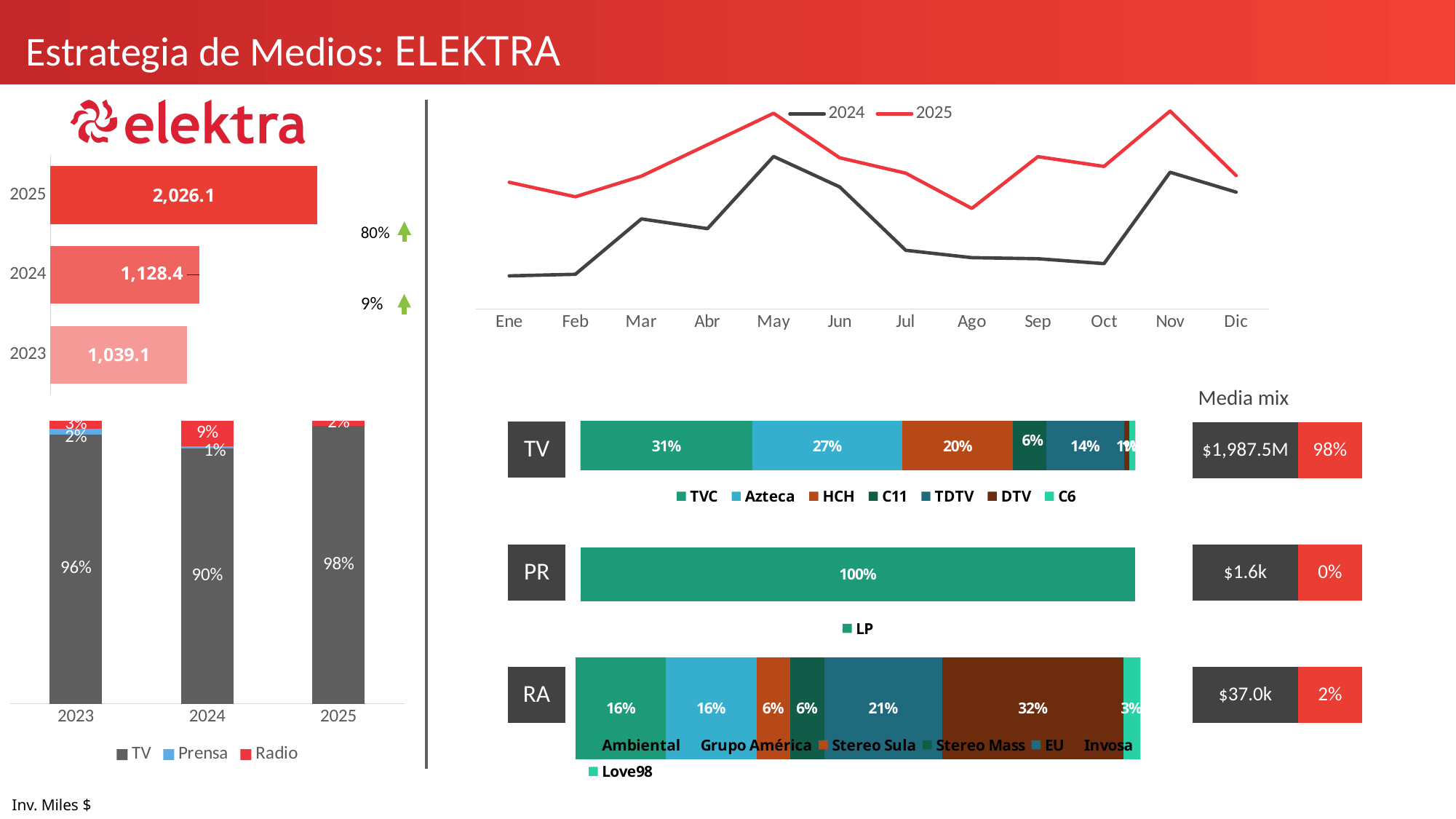
In the yearly investment bar chart on the left, what is the value for 2023? 1,039.1 In the stacked bar chart at the bottom left, what share does TV have in 2024? 90% In the yearly investment bar chart on the left, what is the difference between the 2025 and 2024 values? 897.7 In the TV channel mix bar, what share does Azteca have? 27% In the monthly line chart at the top right, how many months are shown on the x axis? 12 In the stacked bar chart at the bottom left, what share does Radio have in 2024? 9% In the yearly investment bar chart on the left, which year has the lowest value? 2023 How many series does the legend of the stacked bar chart at the bottom left list? 3 In the Media mix table, what is the investment amount shown for RA? $37.0k In the RA (radio) station mix bar, which station has the largest share? Invosa In the monthly line chart at the top right, which month has the highest value for the 2024 series? May In the yearly investment bar chart on the left, what is the value for 2025? 2,026.1